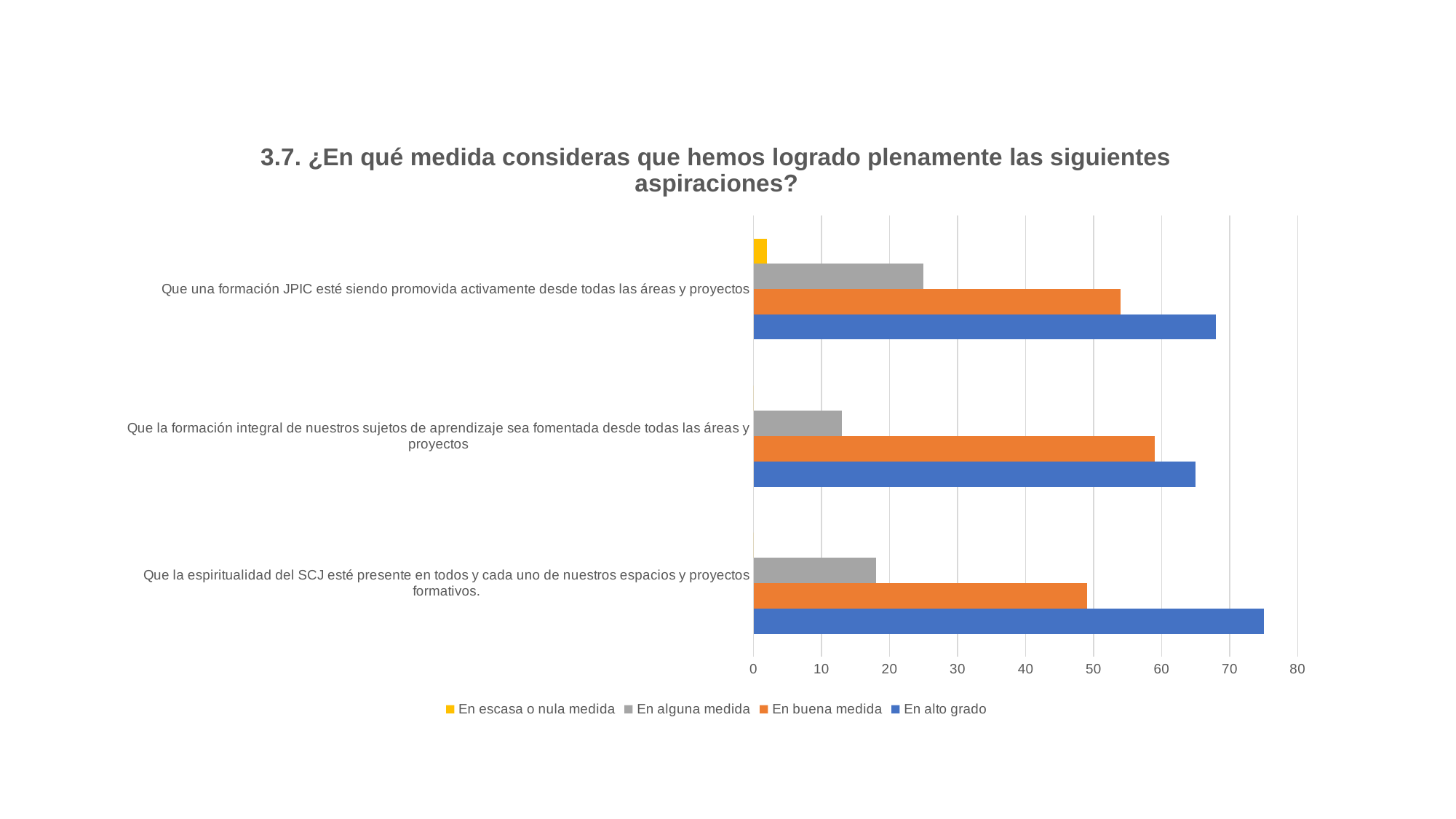
Which category has the highest value for the series "En alto grado"? Que la espiritualidad del SCJ esté presente en todos y cada uno de nuestros espacios y proyectos formativos. Which category has the highest value for the series "En buena medida"? Que la formación integral de nuestros sujetos de aprendizaje sea fomentada desde todas las áreas y proyectos Is the "En alto grado" value for "Que la espiritualidad del SCJ esté presente en todos y cada uno de nuestros espacios y proyectos formativos." greater or less than 70? greater Is the "En alguna medida" value for "Que una formación JPIC esté siendo promovida activamente desde todas las áreas y proyectos" greater or less than 20? greater Which series is shown in yellow in the legend? En escasa o nula medida How many series does the legend list? 4 What kind of chart is shown on the slide? bar chart What is the title of the chart? 3.7. ¿En qué medida consideras que hemos logrado plenamente las siguientes aspiraciones? How many categories (aspirations) are plotted on the chart? 3 Which category has the lowest value for the series "En alguna medida"? Que la formación integral de nuestros sujetos de aprendizaje sea fomentada desde todas las áreas y proyectos For "Que la formación integral de nuestros sujetos de aprendizaje sea fomentada desde todas las áreas y proyectos", which series has the larger value: "En buena medida" or "En alto grado"? En alto grado